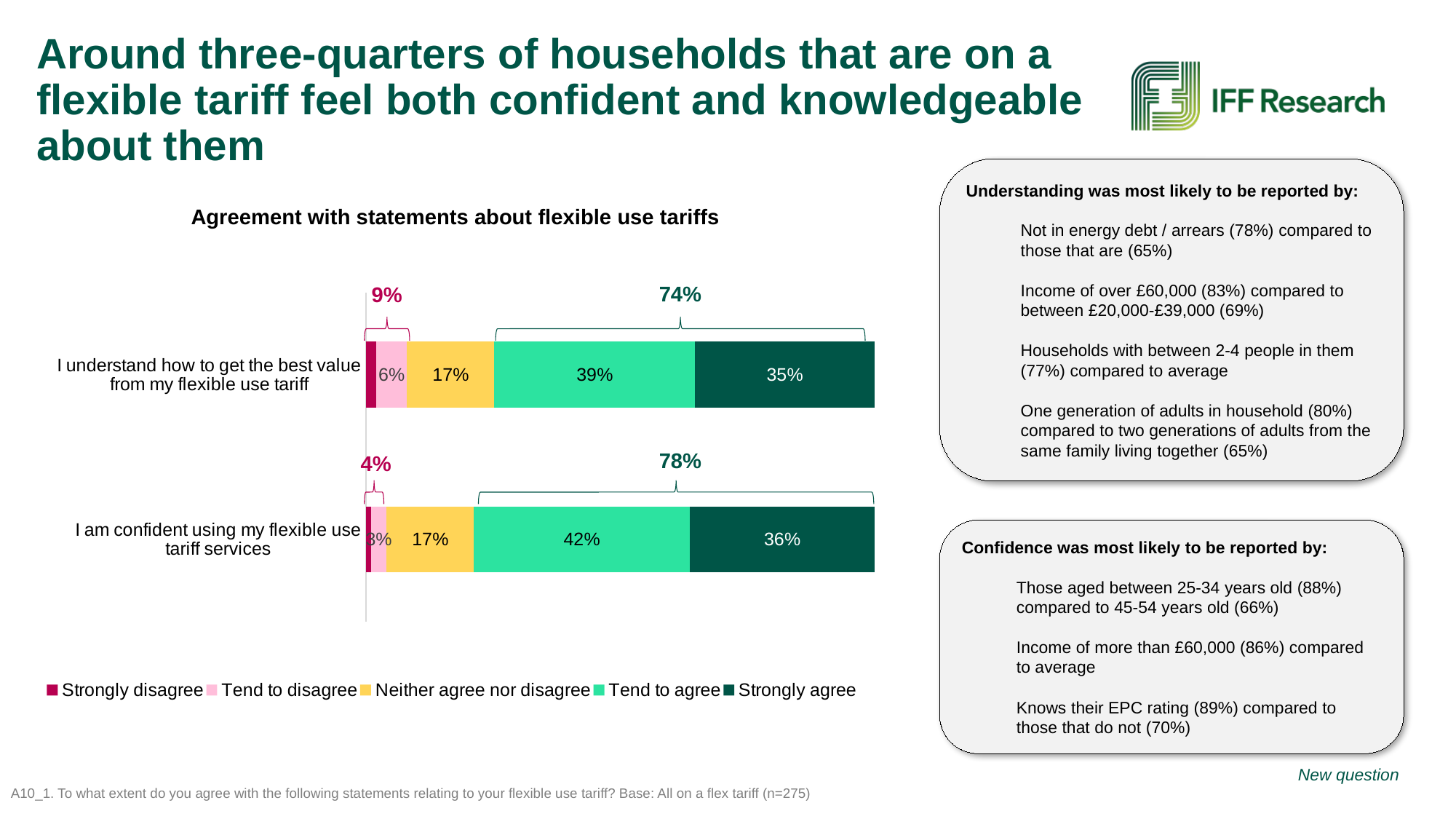
What percentage 'Neither agree nor disagree' with the statement 'I understand how to get the best value from my flexible use tariff'? 17% What is the difference between the 'Tend to agree' percentages for the two statements (42% vs 39%)? 3 percentage points What percentage 'Tend to agree' with the statement 'I understand how to get the best value from my flexible use tariff'? 39% What percentage 'Strongly agree' with the statement 'I am confident using my flexible use tariff services'? 36% What is the combined share of those who disagree with 'I understand how to get the best value from my flexible use tariff', as shown by the bracket label? 9% What is the title of the chart? Agreement with statements about flexible use tariffs Which statement has the larger 'Strongly agree' share: 'I understand how to get the best value from my flexible use tariff' or 'I am confident using my flexible use tariff services'? I am confident using my flexible use tariff services How many statements (categories) are plotted in the chart? 2 What type of chart is shown on the slide? Stacked bar chart What percentage 'Tend to disagree' with the statement 'I understand how to get the best value from my flexible use tariff'? 6% How many series does the legend list? 5 What is the combined share of those who agree (tend to agree plus strongly agree) with 'I am confident using my flexible use tariff services', as shown by the bracket label? 78%